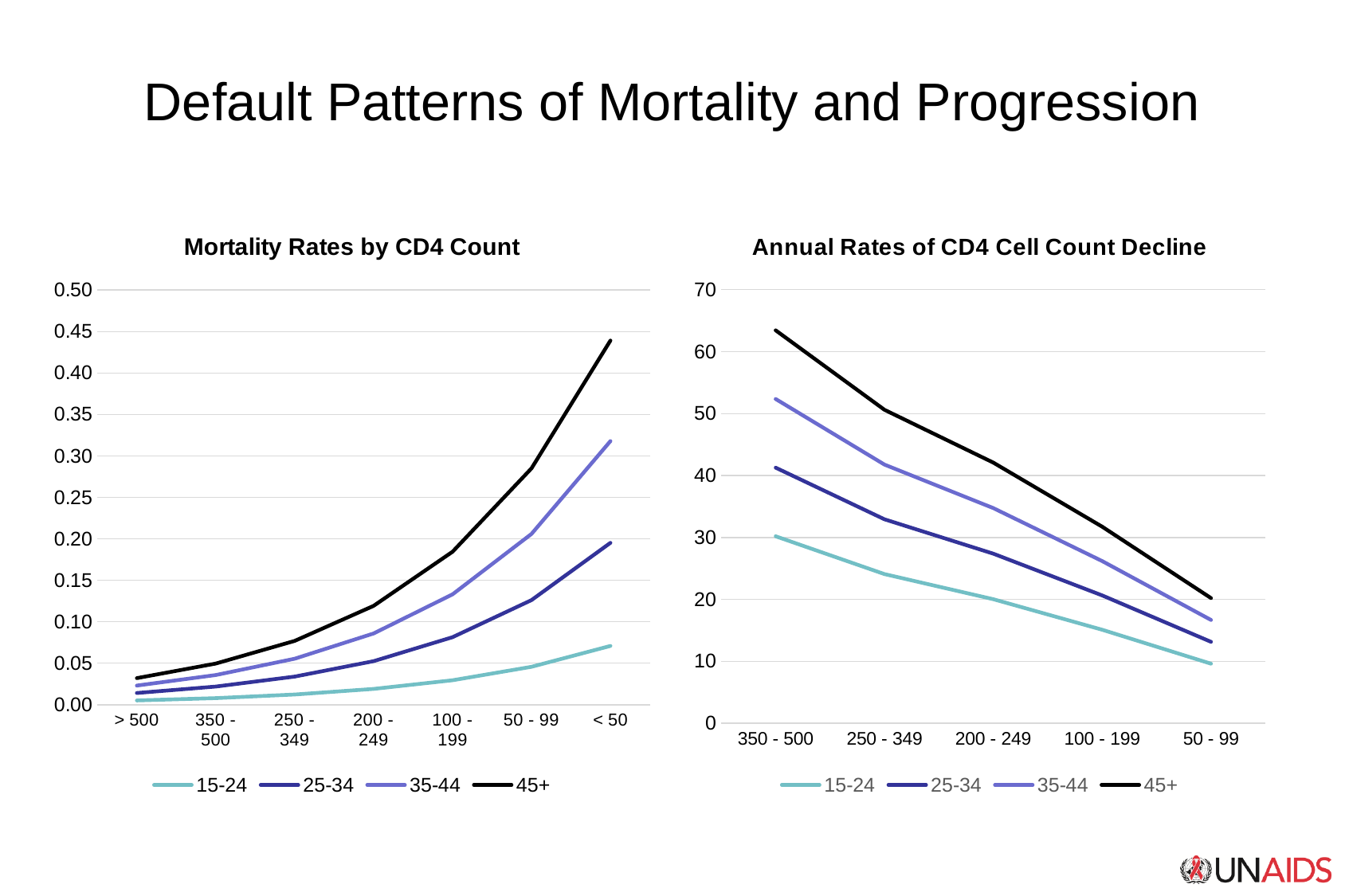
In the 'Mortality Rates by CD4 Count' chart, is the value for the 45+ series at '< 50' greater or less than 0.40? greater How many CD4 count categories are shown on the x axis of the 'Annual Rates of CD4 Cell Count Decline' chart? 5 In the 'Mortality Rates by CD4 Count' chart, is the value for the 15-24 series at '< 50' greater or less than 0.10? less In the 'Mortality Rates by CD4 Count' chart, which age group has the highest mortality rate at the '< 50' category? 45+ In the 'Annual Rates of CD4 Cell Count Decline' chart, which age group has the lowest value at the '350 - 500' category? 15-24 What kind of chart is the 'Mortality Rates by CD4 Count' chart? line chart In the 'Mortality Rates by CD4 Count' chart, do the values for the 45+ series rise or fall from left to right along the x axis? rise How many CD4 count categories are shown on the x axis of the 'Mortality Rates by CD4 Count' chart? 7 How many series does the legend of the 'Annual Rates of CD4 Cell Count Decline' chart list? 4 In the 'Annual Rates of CD4 Cell Count Decline' chart, which is larger at '50 - 99': the value for 35-44 or the value for 25-34? 35-44 In the 'Annual Rates of CD4 Cell Count Decline' chart, is the value for the 45+ series at '350 - 500' greater or less than 60? greater In the 'Annual Rates of CD4 Cell Count Decline' chart, do the values for the 15-24 series rise or fall from left to right along the x axis? fall